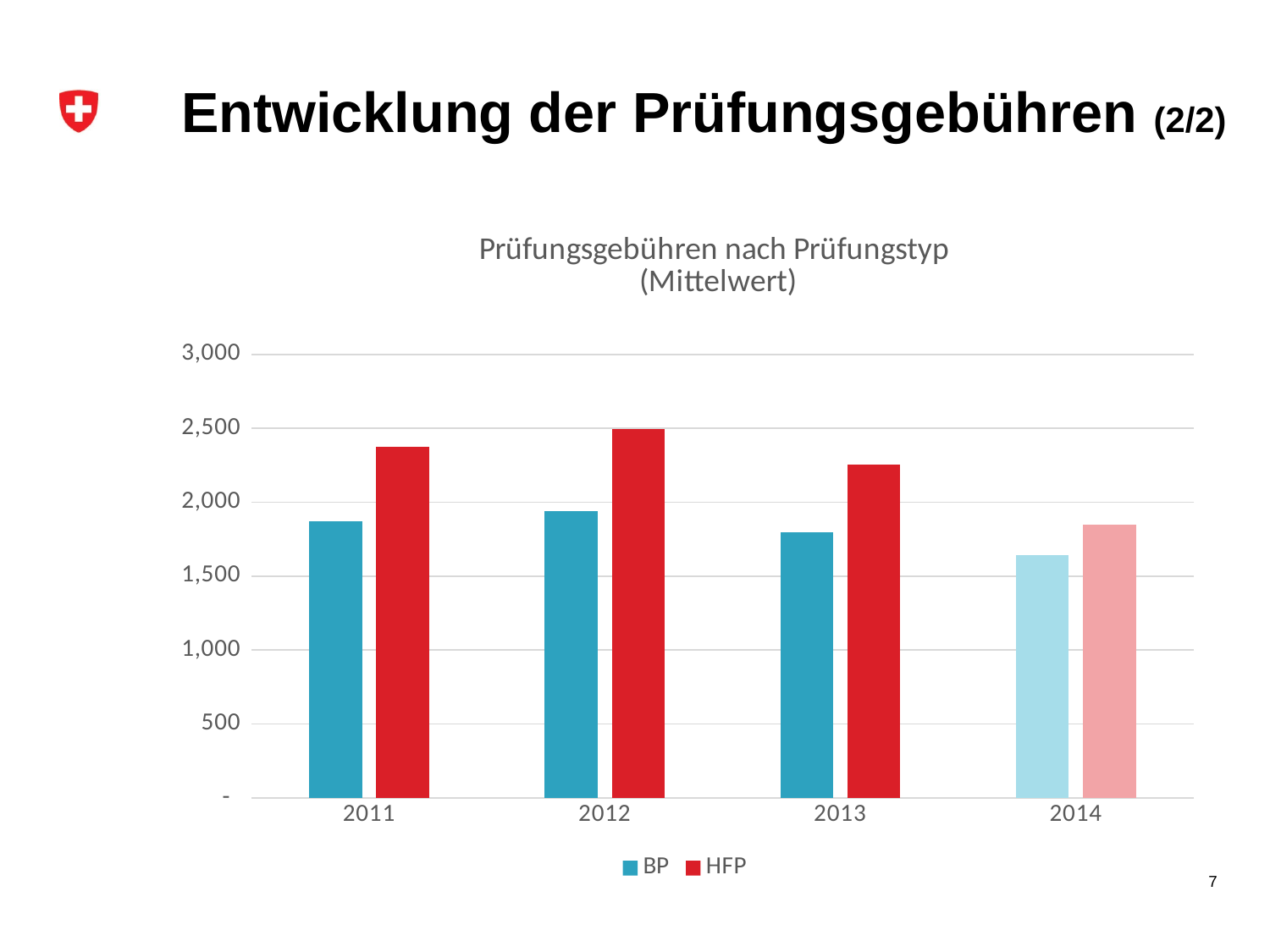
Is the HFP value for 2013 greater or less than 2,000? greater In which year is the HFP value lowest? 2014 How many years are shown on the x axis? 4 How many series does the legend list? 2 What is the title of the chart? Prüfungsgebühren nach Prüfungstyp (Mittelwert) Is the HFP value for 2014 greater or less than 2,000? less What kind of chart is shown on the slide? bar chart Do the HFP values rise or fall from 2012 to 2014? fall Is the BP value for 2014 greater or less than 1,500? greater Which is larger in 2013, BP or HFP? HFP In which year is the BP value lowest? 2014 In which year is the HFP value highest? 2012